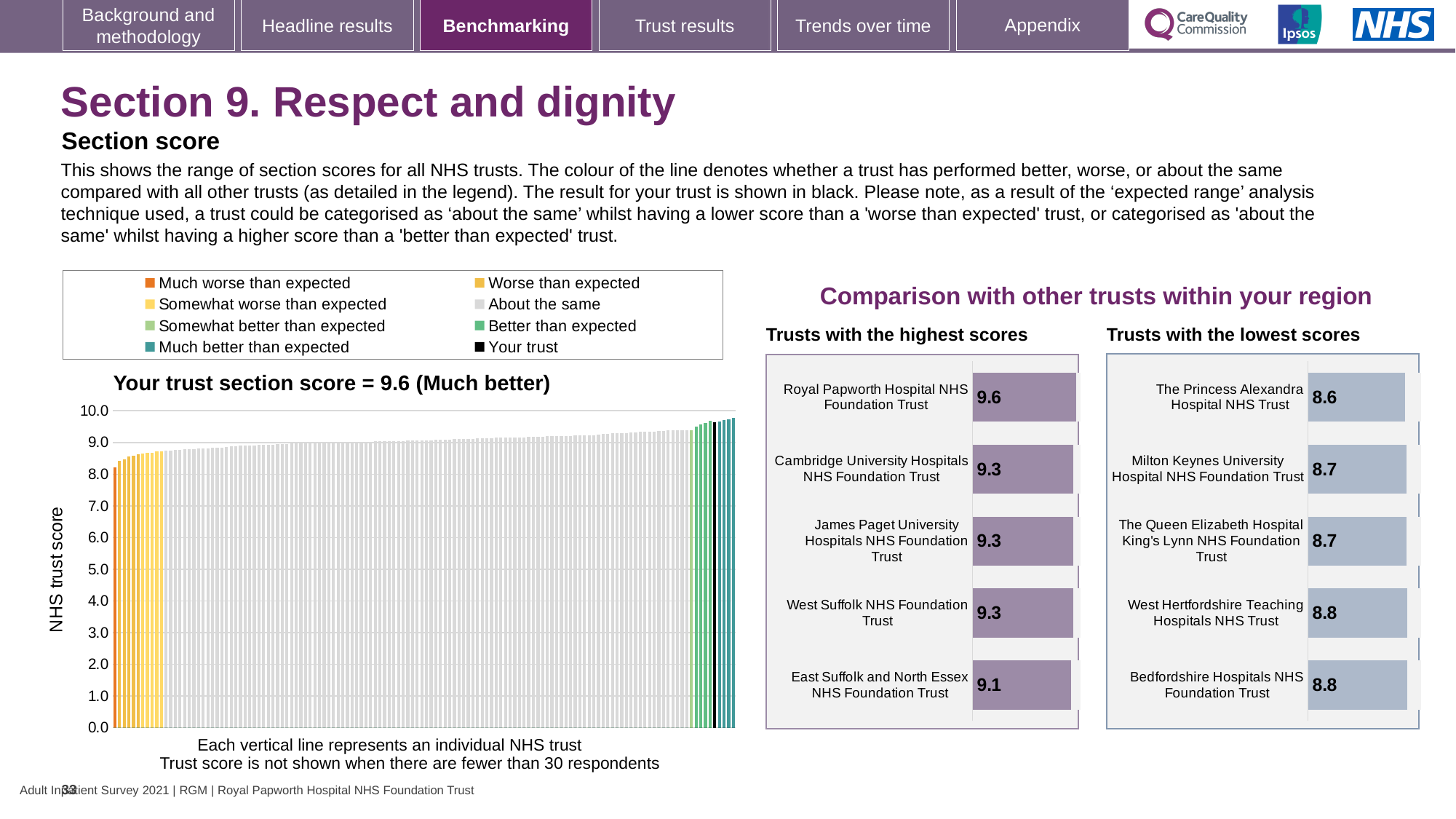
How many trusts are listed in the 'Trusts with the lowest scores' chart? 5 In the 'Trusts with the highest scores' chart, what is the score for East Suffolk and North Essex NHS Foundation Trust? 9.1 In the 'Trusts with the lowest scores' chart, what is the score for The Princess Alexandra Hospital NHS Trust? 8.6 In the 'Trusts with the lowest scores' chart, which trust has the lowest score? The Princess Alexandra Hospital NHS Trust In the 'Trusts with the lowest scores' chart, what is the difference between the scores of Bedfordshire Hospitals NHS Foundation Trust and The Princess Alexandra Hospital NHS Trust? 0.2 In the 'Your trust section score' chart, do the values rise or fall from left to right along the x axis? Rise Which has a higher score: Cambridge University Hospitals NHS Foundation Trust in the highest scores chart, or West Hertfordshire Teaching Hospitals NHS Trust in the lowest scores chart? Cambridge University Hospitals NHS Foundation Trust In the 'Trusts with the highest scores' chart, what is the score for Royal Papworth Hospital NHS Foundation Trust? 9.6 In the 'Trusts with the highest scores' chart, which trust has the highest score? Royal Papworth Hospital NHS Foundation Trust What kind of chart is the 'Your trust section score' chart on the left? Bar chart In the 'Your trust section score' chart, is the value of the leftmost bar greater or less than 9.0? less In the 'Trusts with the highest scores' chart, what is the difference between the scores of Royal Papworth Hospital NHS Foundation Trust and East Suffolk and North Essex NHS Foundation Trust? 0.5